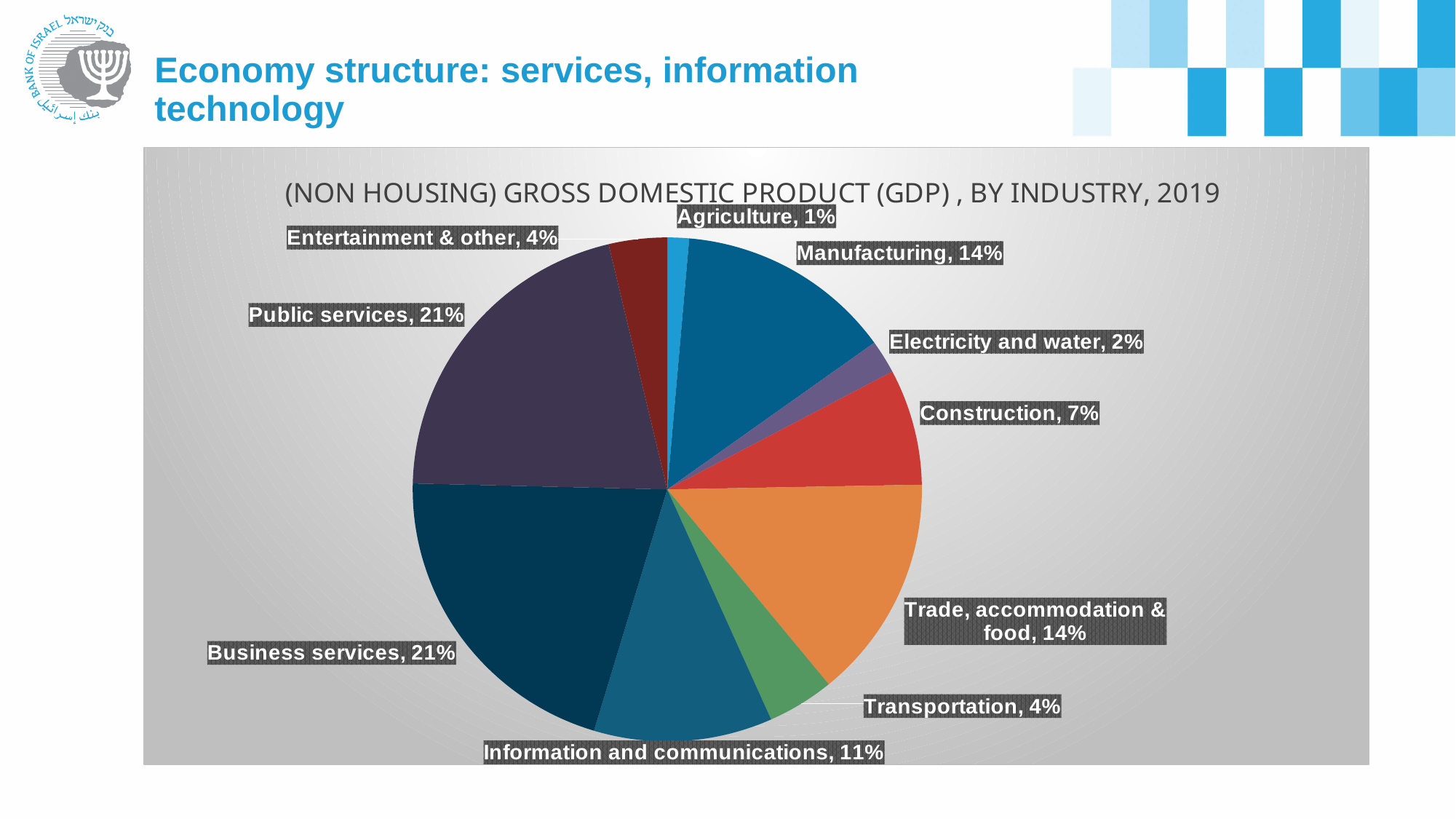
What is the difference between the shares of Business services and Information and communications? 10% What is the difference between the shares of Manufacturing and Construction? 7% Which is larger, the share for Public services or the share for Trade, accommodation & food? Public services Which is larger, the share for Transportation or the share for Construction? Construction What year does the chart title say the GDP data refers to? 2019 Which industry has the smallest share of GDP in the pie chart? Agriculture What percentage is shown for Construction? 7% How many industry categories are shown in the pie chart? 10 What is the share for Information and communications? 11% What share of GDP does Manufacturing account for in the pie chart? 14% What type of chart is shown on the slide? Pie chart What share is shown for Electricity and water? 2%